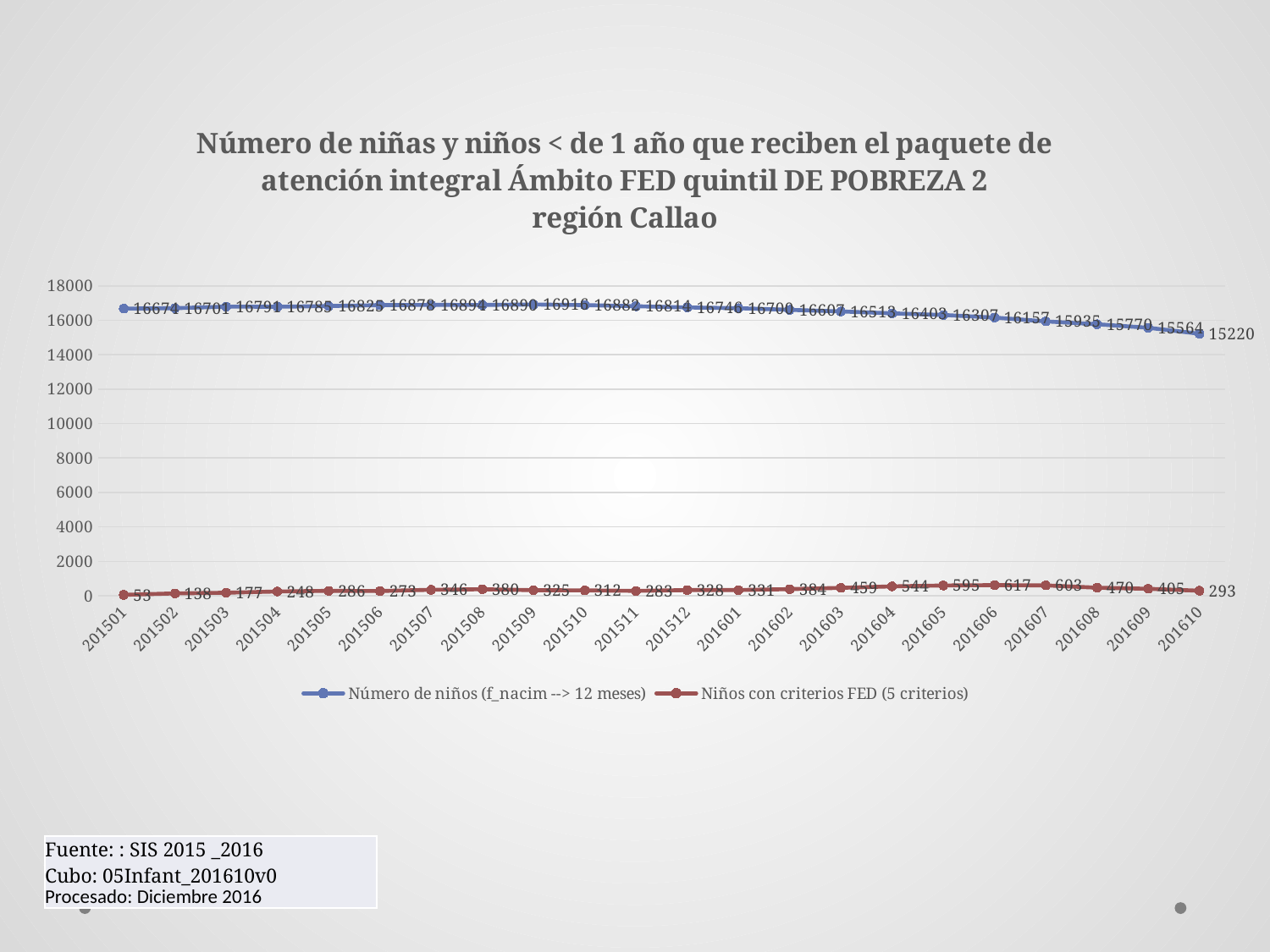
What kind of chart is shown on the slide? line chart What is the difference between the highest value of 'Niños con criterios FED (5 criterios)' (201606) and its value at 201501? 564 How many months are plotted on the x axis? 22 In which month is the 'Número de niños (f_nacim --> 12 meses)' series at its lowest? 201610 Does the 'Número de niños (f_nacim --> 12 meses)' series rise or fall from 201601 to 201610? fall How many series does the legend list? 2 In which month is the 'Niños con criterios FED (5 criterios)' series at its lowest? 201501 What is the value of the 'Niños con criterios FED (5 criterios)' series at 201610? 293 In which month does the 'Niños con criterios FED (5 criterios)' series reach its highest value? 201606 Is the value of 'Número de niños (f_nacim --> 12 meses)' at 201610 greater or less than 16000? less What is the value of the 'Número de niños (f_nacim --> 12 meses)' series at 201610? 15220 What is the value of the 'Niños con criterios FED (5 criterios)' series at 201501? 53